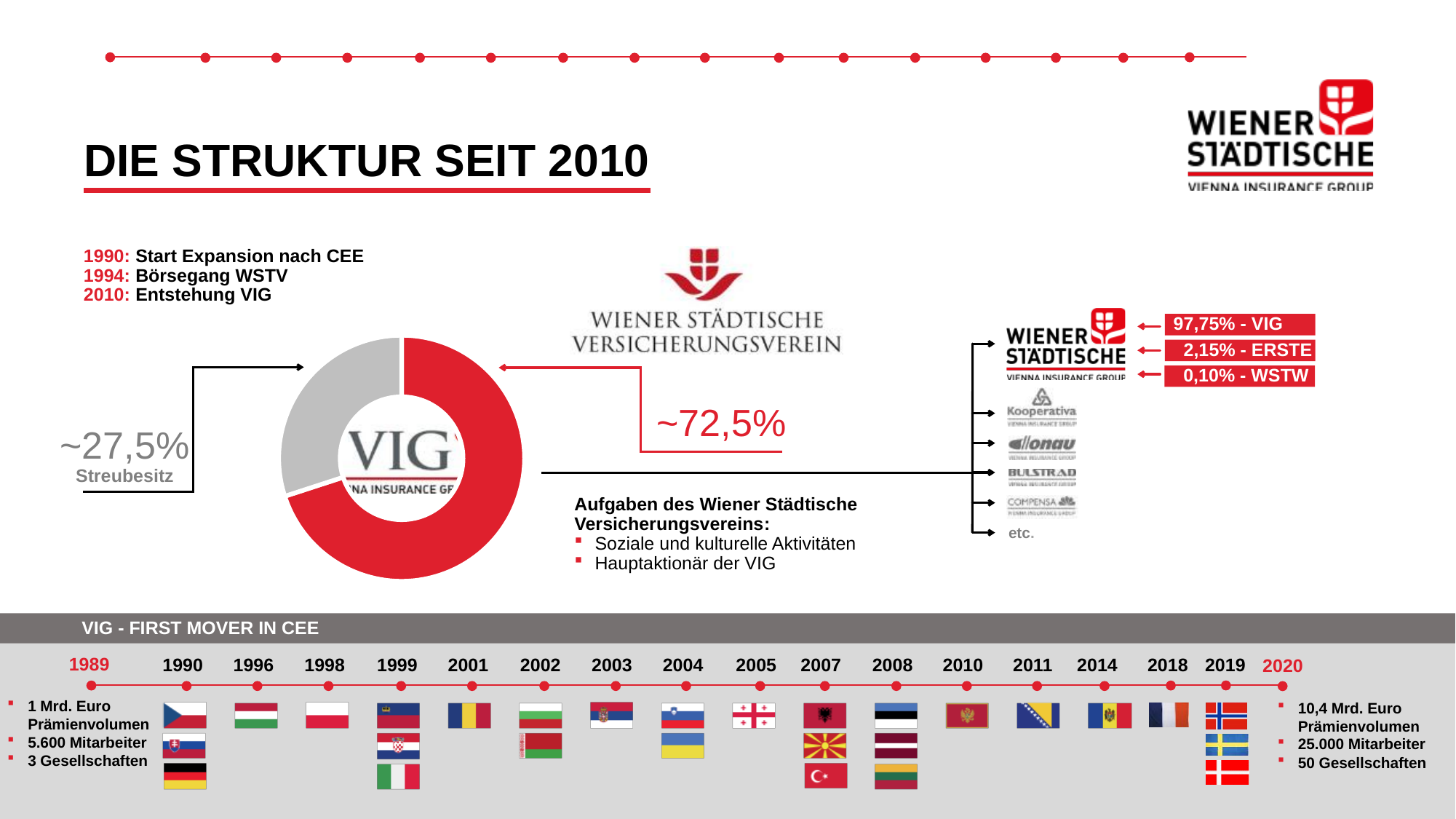
Which is larger in the donut chart: the Streubesitz share or the Wiener Städtische Versicherungsverein share? Wiener Städtische Versicherungsverein Which logo is shown in the centre of the donut chart? VIG (Vienna Insurance Group) What colour is the Streubesitz slice in the donut chart? Grey Which slice of the donut chart is the largest? Wiener Städtische Versicherungsverein Is the Streubesitz slice of the donut chart more or less than half of the chart? less Which slice of the donut chart is the smallest? Streubesitz How many slices does the donut chart have? 2 What kind of chart is shown in the middle of the slide? Pie chart (donut)